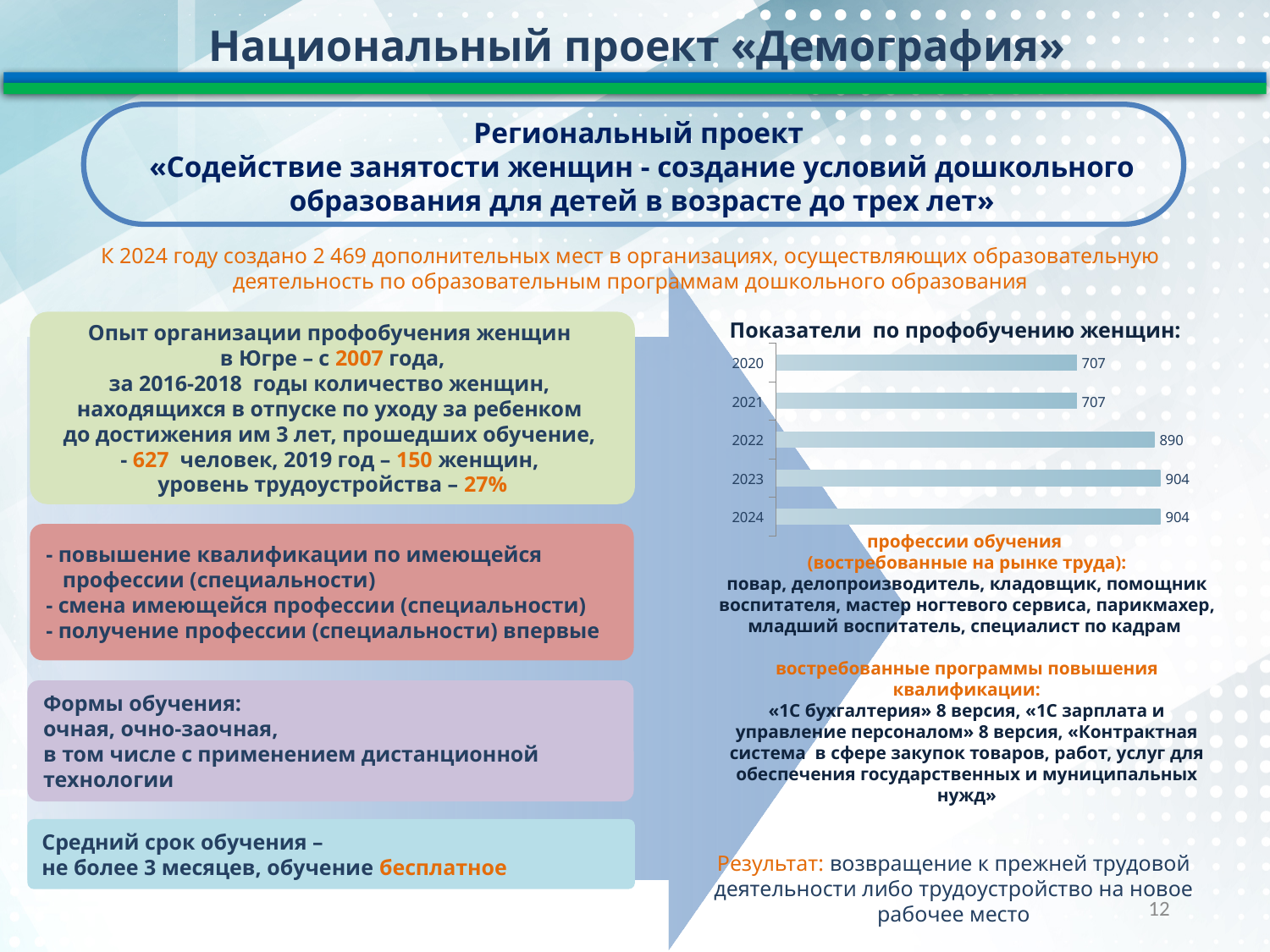
What is the value for 2020 in the chart "Показатели по профобучению женщин"? 707 What kind of chart is "Показатели по профобучению женщин"? Bar chart What is the difference between the values for 2022 and 2021 in the chart "Показатели по профобучению женщин"? 183 What is the value for 2021 in the chart "Показатели по профобучению женщин"? 707 What is the value for 2024 in the chart "Показатели по профобучению женщин"? 904 What is the value for 2022 in the chart "Показатели по профобучению женщин"? 890 Which years share the lowest value in the chart "Показатели по профобучению женщин"? 2020 and 2021 How many years (categories) are shown in the chart "Показатели по профобучению женщин"? 5 Do the values in the chart "Показатели по профобучению женщин" generally rise or fall from 2020 to 2024? Rise What is the title of the chart on the slide? Показатели по профобучению женщин What is the difference between the values for 2023 and 2022 in the chart "Показатели по профобучению женщин"? 14 Which is larger in the chart "Показатели по профобучению женщин": the value for 2022 or the value for 2020? 2022